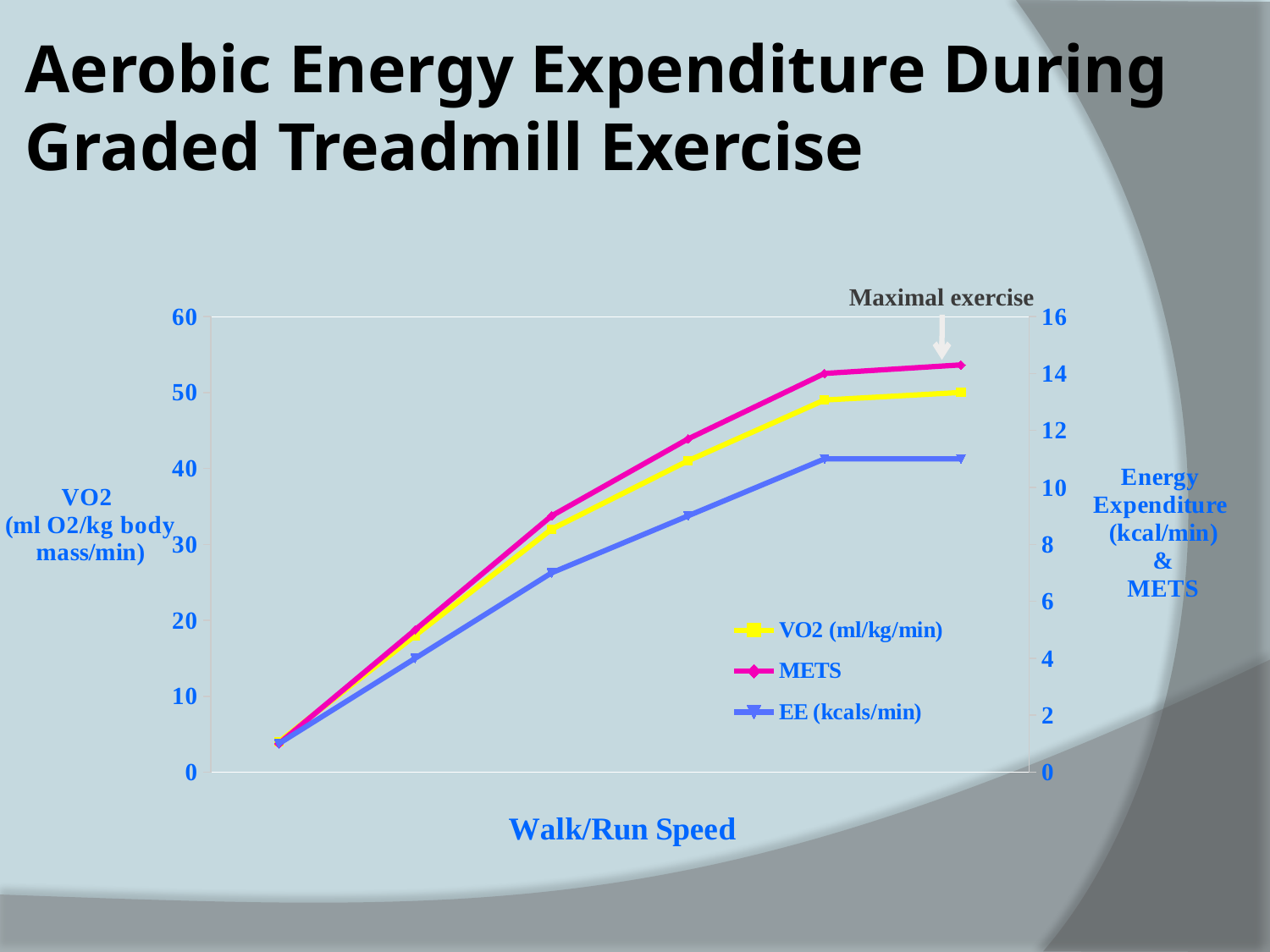
Which series are listed in the legend? VO2 (ml/kg/min), METS, EE (kcals/min) Which series' line is the lowest on the chart at the final point? EE (kcals/min) Is the first VO2 (ml/kg/min) value greater or less than 10 on the left axis? less What kind of chart is shown on the slide? line chart Is the final EE (kcals/min) value greater or less than 14 on the right axis? less Which series' line reaches the highest point on the chart? METS Is the final METS value greater or less than 12 on the right axis? greater What is the title of the x axis? Walk/Run Speed Do the plotted values rise or fall as Walk/Run Speed increases along the x axis? rise How many series does the legend list? 3 How many data points are plotted on each line? 6